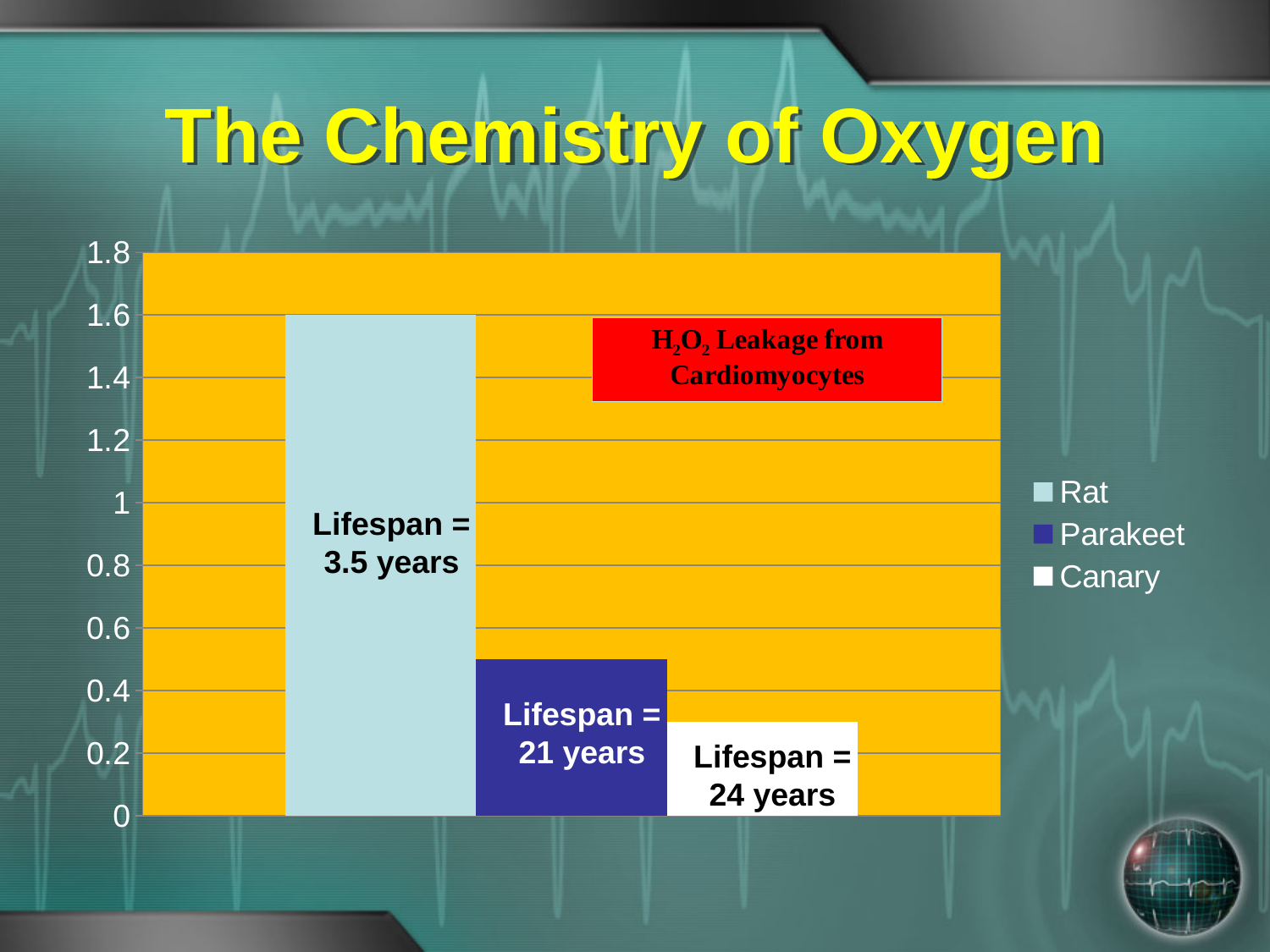
How many series does the legend list? 3 Is the value for Rat greater or less than 1.4? greater Which series has the lowest H2O2 leakage bar? Canary What lifespan is printed on the Rat bar? 3.5 years What quantity does the red text box say the chart shows? H2O2 Leakage from Cardiomyocytes Which bar is taller, Parakeet or Canary? Parakeet What kind of chart is shown on the slide? bar chart Is the value for Parakeet greater or less than 0.6? less What lifespan is printed on the Canary bar? 24 years Is the value for Parakeet greater or less than 0.4? greater Which series has the highest H2O2 leakage bar? Rat